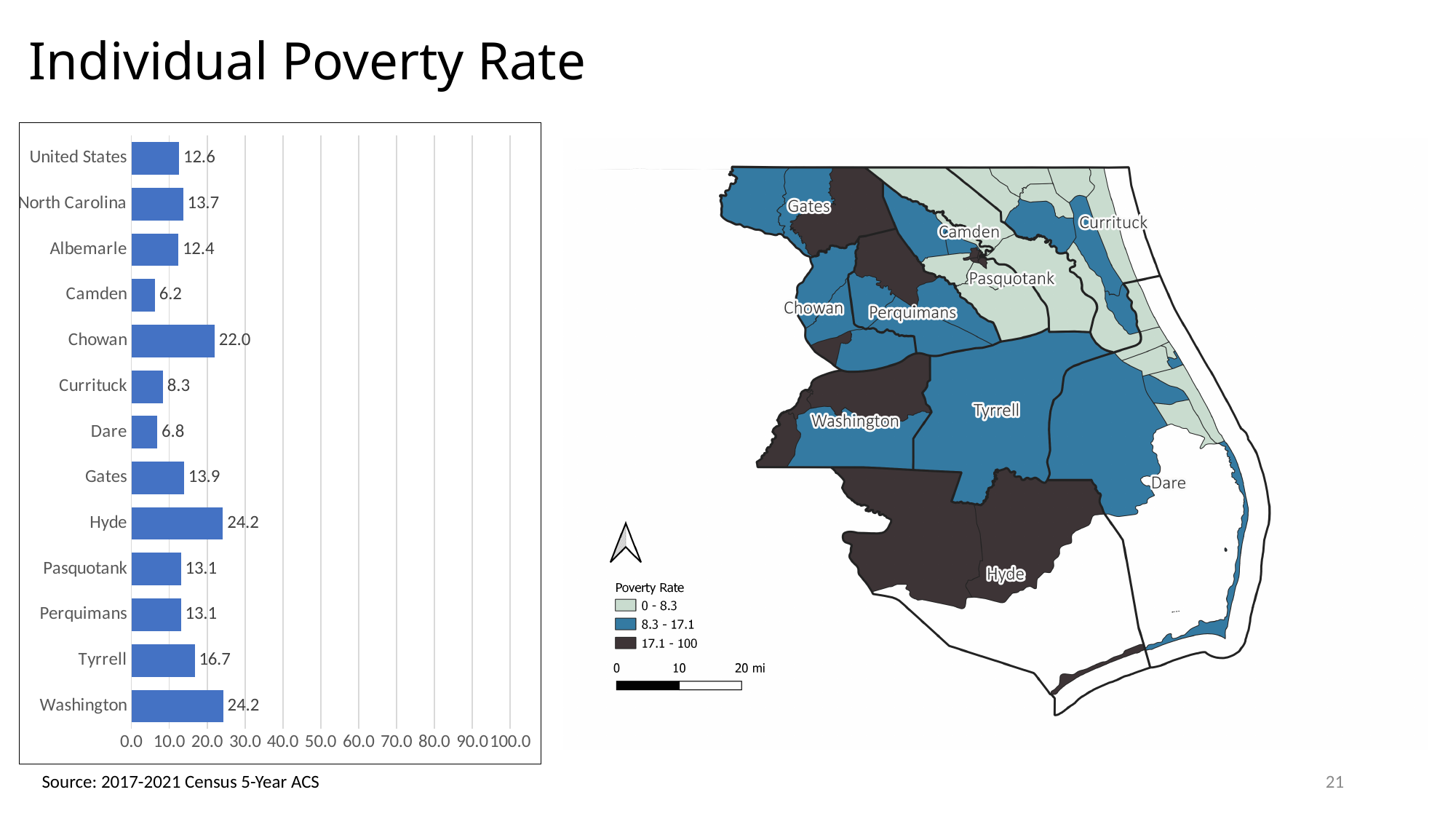
Which has a higher individual poverty rate, Chowan or Tyrrell? Chowan What is the individual poverty rate shown for Currituck? 8.3 What kind of chart is shown on the left of the slide? Bar chart What is the individual poverty rate shown for the United States? 12.6 What is the difference between the poverty rates of Hyde and Camden? 18.0 What is the individual poverty rate shown for Tyrrell? 16.7 Which has a higher individual poverty rate, Gates or Dare? Gates Which category has the lowest individual poverty rate in the bar chart? Camden What is the difference between the poverty rates of North Carolina and Albemarle? 1.3 What is the individual poverty rate shown for Chowan? 22.0 How many categories are shown in the bar chart? 13 Is the value for Washington greater or less than 20.0? greater